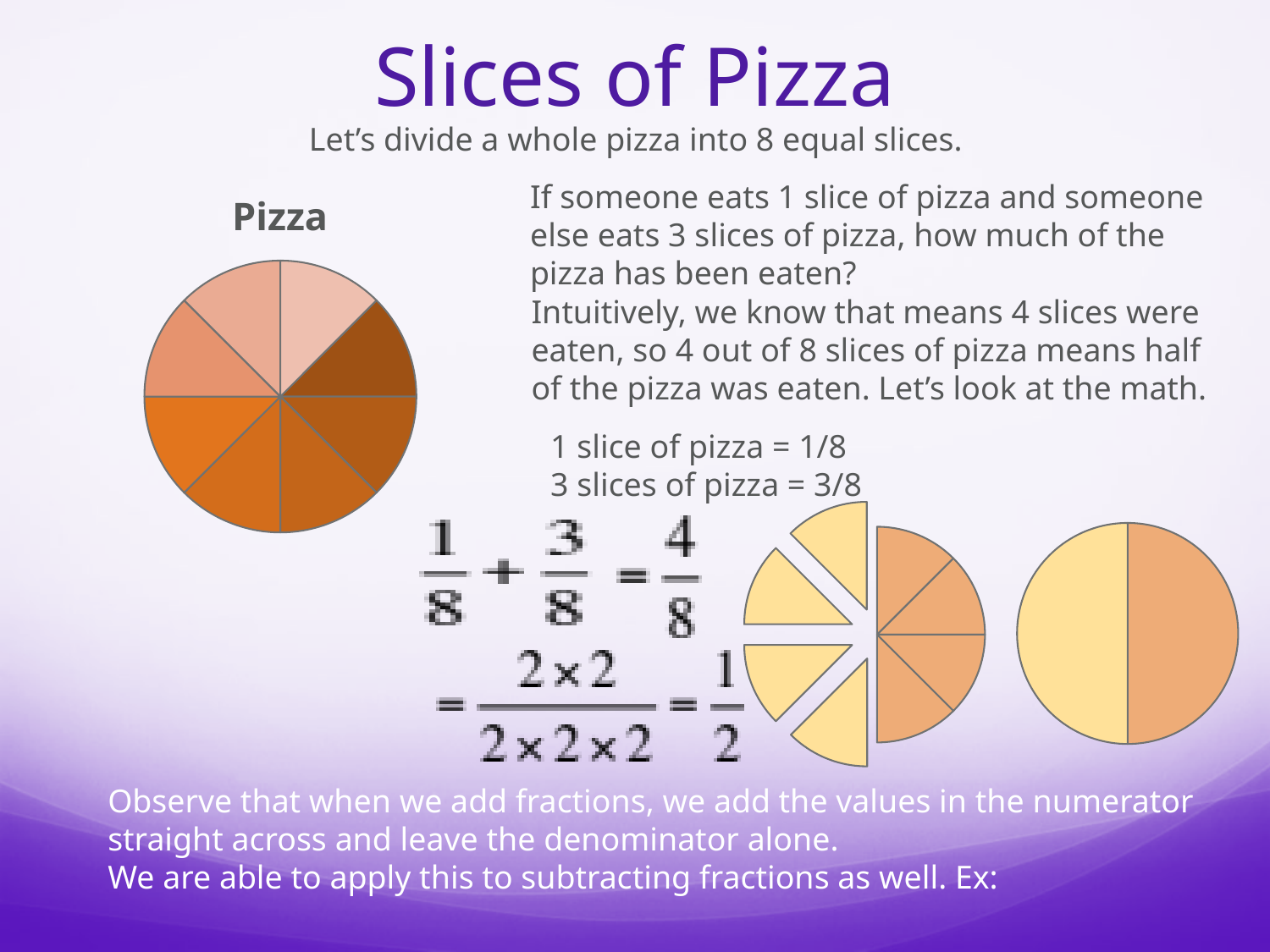
What is the title of the pie chart on the left of the slide? Pizza What kind of chart is shown under the heading "Pizza"? pie chart How many slices does the "Pizza" pie chart have? 8 What share of the whole pizza do 3 slices of the "Pizza" pie chart represent? 3/8 What share of the whole pizza do 4 slices of the "Pizza" pie chart represent? 4/8 What share of the whole pizza does one slice of the "Pizza" pie chart represent? 1/8 Are the slices of the "Pizza" pie chart equal in size? yes Does the "Pizza" pie chart have a legend? no